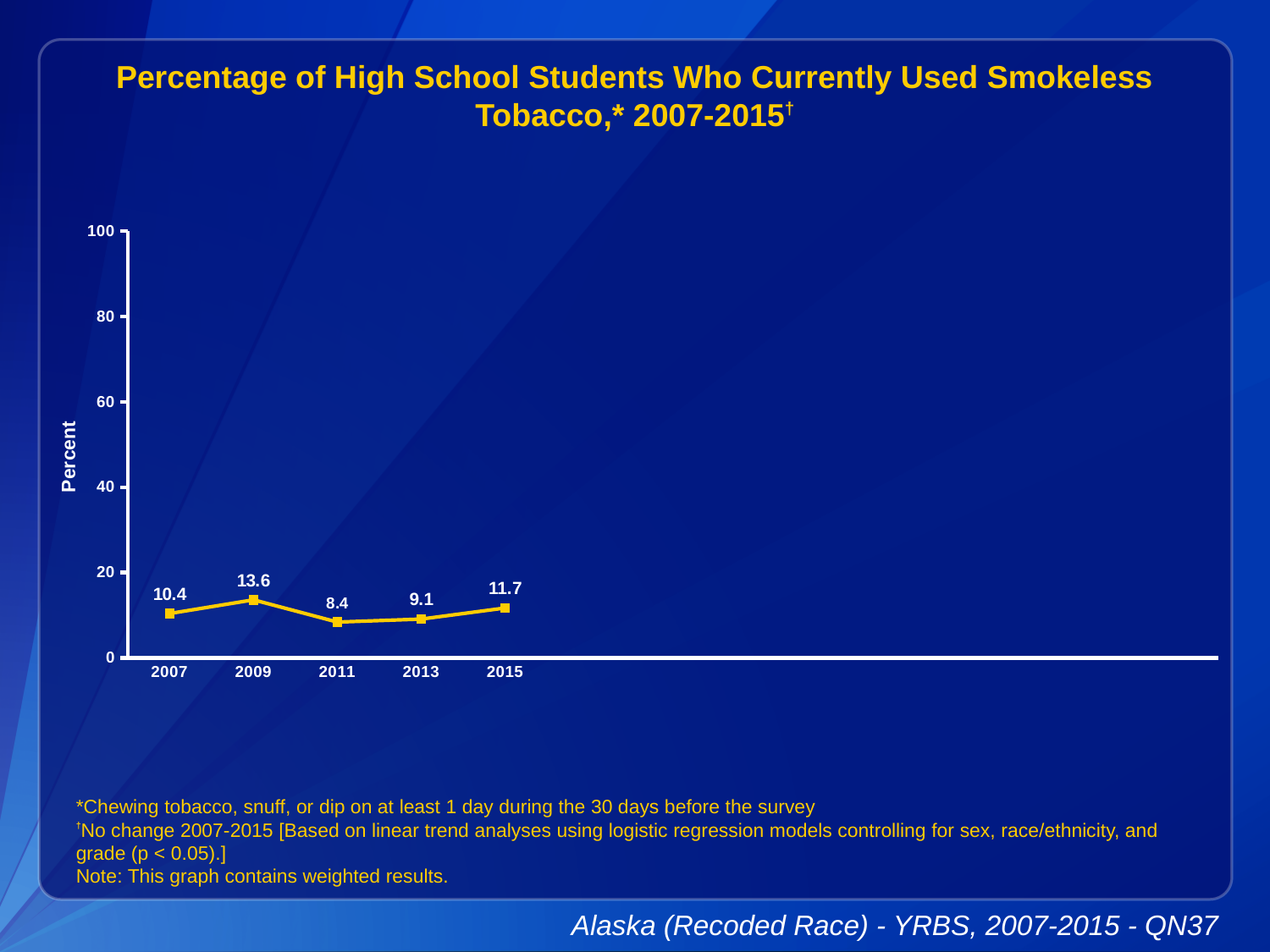
Which year has the lowest percentage of students who currently used smokeless tobacco? 2011 What is the difference between the 2009 value and the 2011 value? 5.2 What is the value plotted for 2015? 11.7 Which year has the highest percentage of students who currently used smokeless tobacco? 2009 Which year has a larger value, 2007 or 2013? 2007 What is the value plotted for 2011? 8.4 What percentage of high school students currently used smokeless tobacco in 2007? 10.4 How many years are plotted on the chart? 5 What is the difference between the 2015 value and the 2013 value? 2.6 What is the label on the y axis of the chart? Percent What kind of chart is shown on the slide? line chart Is the value for 2009 greater or less than 20? less